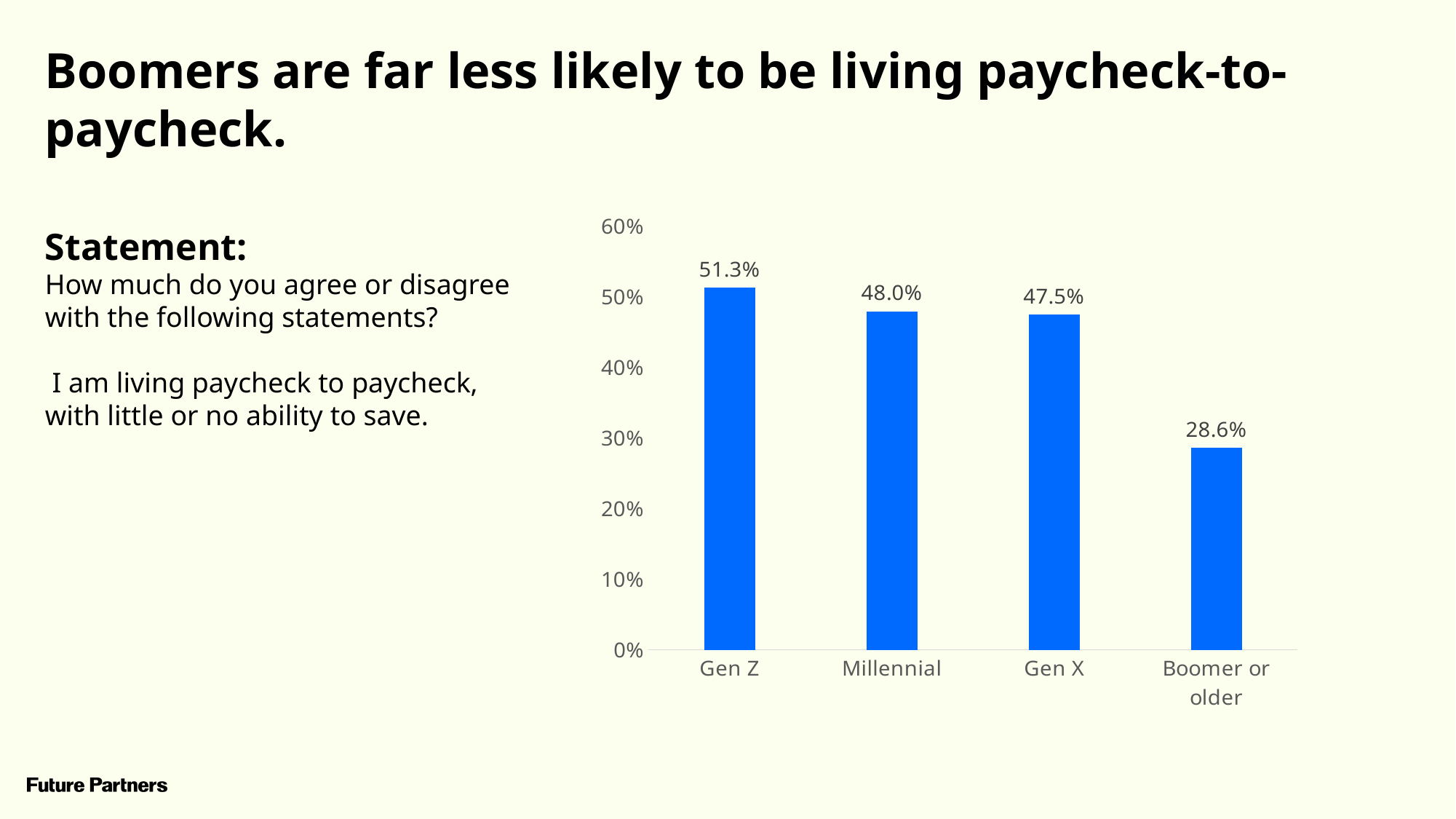
What is the value for Gen X? 47.5% What is the difference between the values for Millennial and Gen X? 0.5% What kind of chart is shown on the slide? bar chart Is the value for Boomer or older greater or less than 30%? less What is the value for Boomer or older? 28.6% Which category has the lowest value? Boomer or older What is the value for Gen Z? 51.3% What is the value for Millennial? 48.0% How many categories are shown on the x axis? 4 Which is larger, the value for Gen X or the value for Boomer or older? Gen X Which category has the highest value? Gen Z What is the difference between the values for Gen Z and Boomer or older? 22.7%